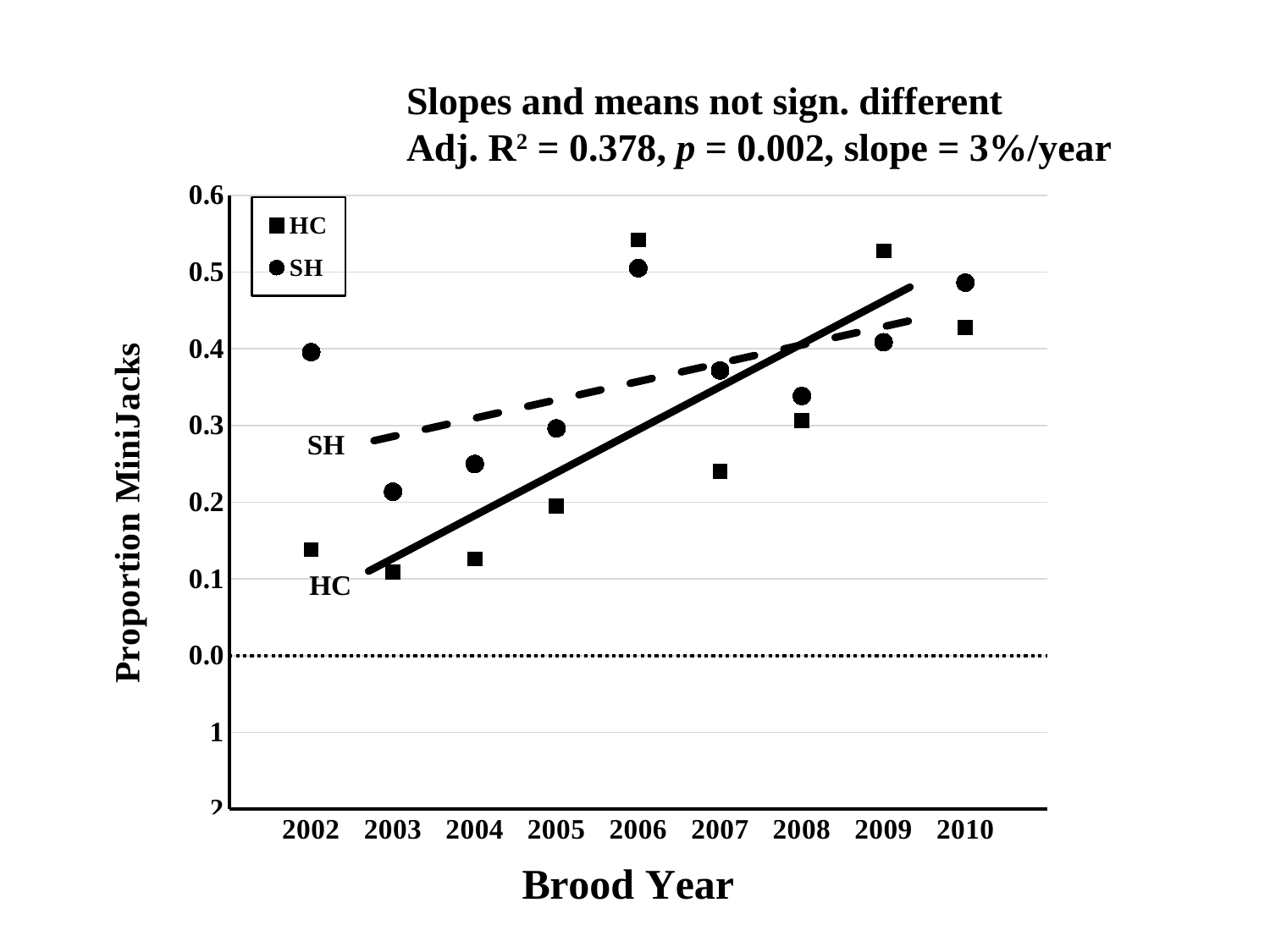
For brood year 2010, which series has the larger value, HC or SH? SH Is the HC value for brood year 2006 greater or less than 0.5? greater What kind of chart is shown on the slide? scatter plot For brood year 2002, which series has the larger value, HC or SH? SH Is the SH value for brood year 2002 greater or less than 0.3? greater How many brood years are shown on the x axis? 9 Which brood year has the lowest SH value? 2003 How many series does the legend list? 2 What is the title of the y axis? Proportion MiniJacks Do the fitted trend lines for HC and SH rise or fall across the brood years? rise Is the SH value for brood year 2010 greater or less than 0.4? greater